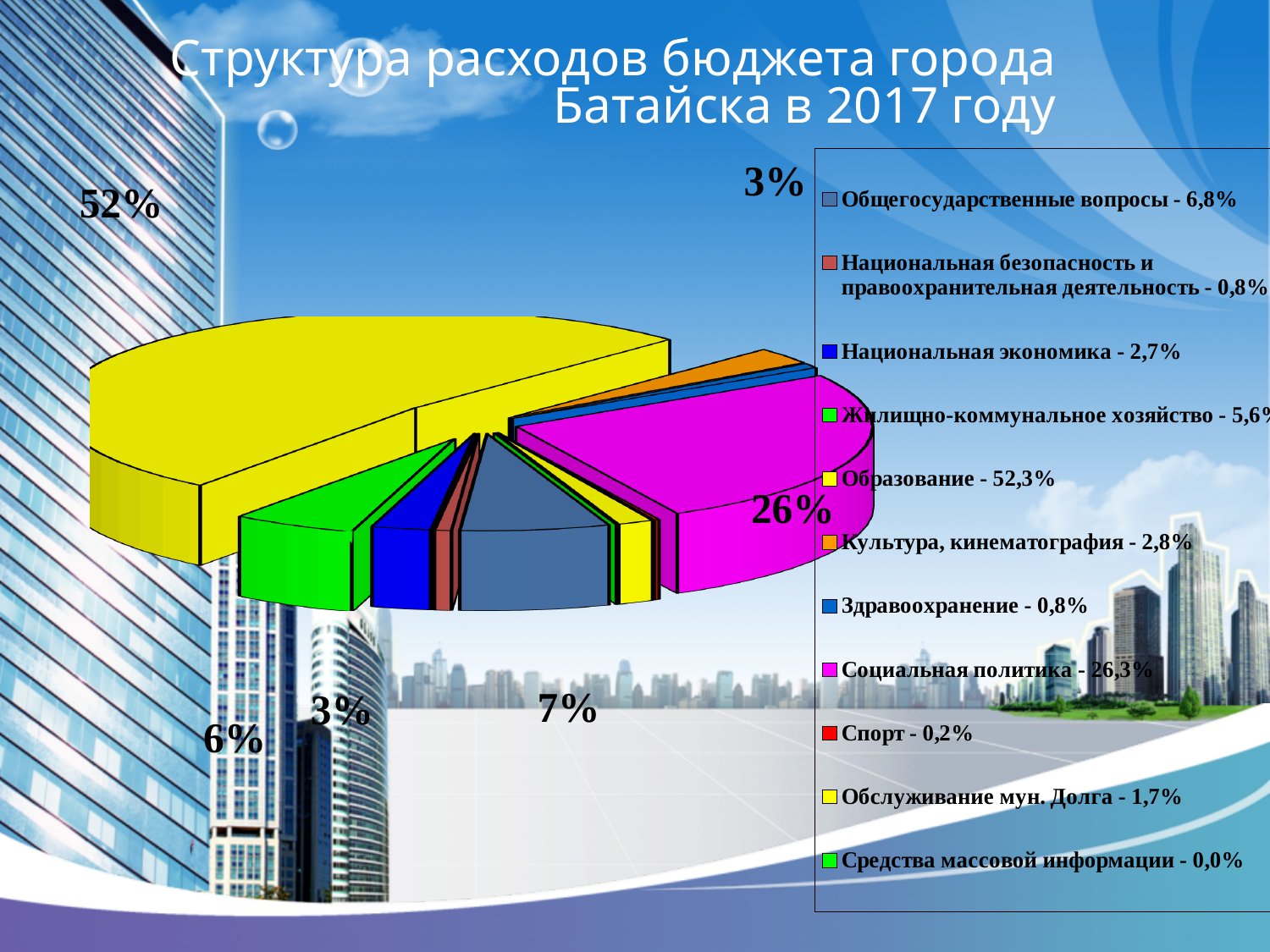
What share of expenditures goes to Образование according to the legend? 52,3% What kind of chart is shown on the slide? pie chart Which category has the largest share of the budget expenditures? Образование By how many percentage points does the share for Образование exceed the share for Социальная политика? 26,0 percentage points What share of expenditures goes to Спорт according to the legend? 0,2% How many categories does the legend of the pie chart list? 11 What share of expenditures goes to Социальная политика according to the legend? 26,3% What share of expenditures goes to Жилищно-коммунальное хозяйство according to the legend? 5,6% What share of expenditures goes to Общегосударственные вопросы according to the legend? 6,8% Which is larger: the share for Национальная экономика or the share for Культура, кинематография? Культура, кинематография Which category has the smallest share of the budget expenditures? Средства массовой информации What is the title of the chart on the slide? Структура расходов бюджета города Батайска в 2017 году